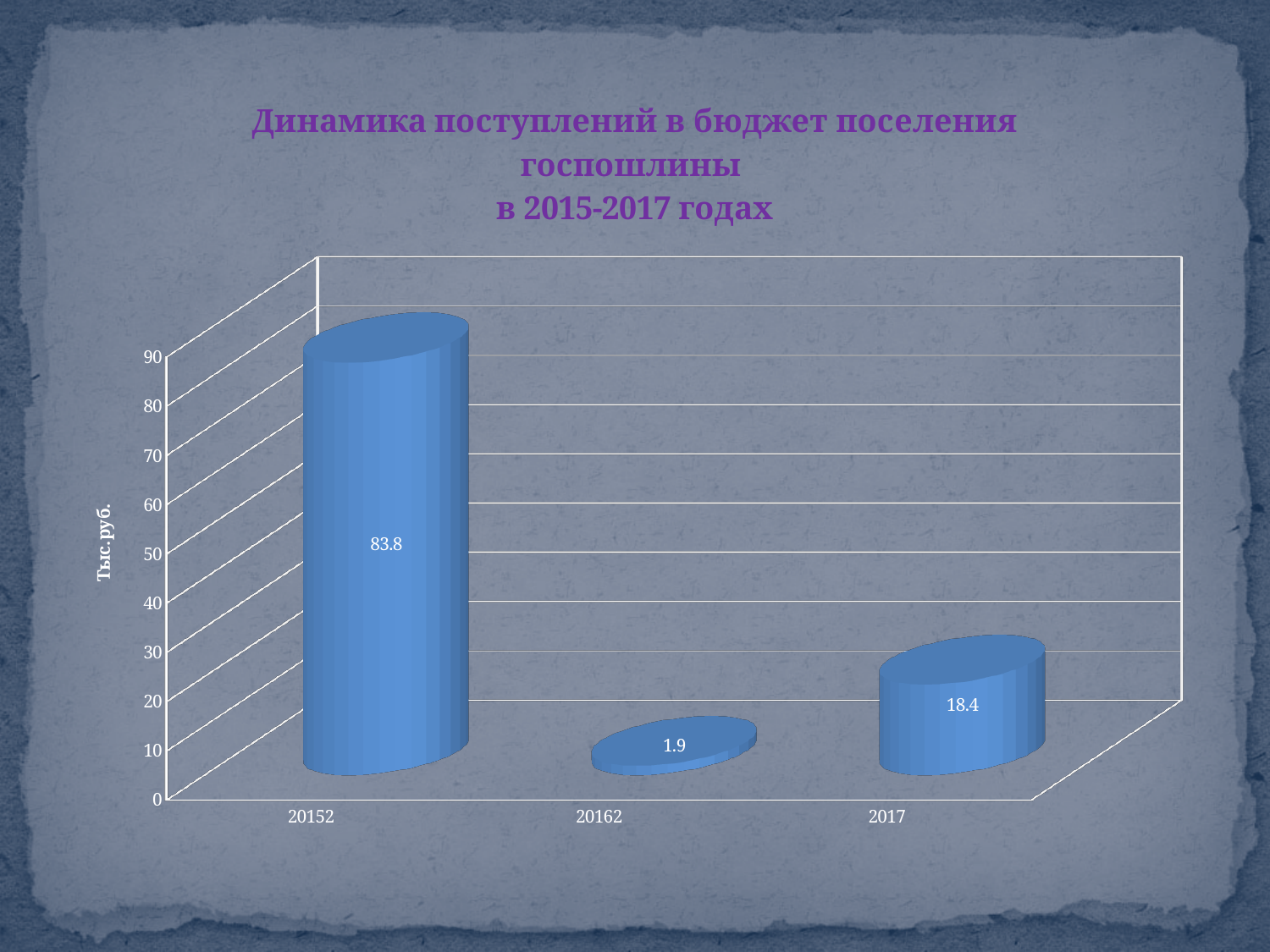
Which category has the lowest value? 20162 What is the value for 2017? 18.4 What is the label of the vertical axis? Тыс.руб. How many categories are shown on the x axis? 3 Which is larger, the value for 2017 or the value for 20162? 2017 What is the difference between the values for 20152 and 2017? 65.4 What is the value for the category labelled 20162? 1.9 Is the value for 20152 greater or less than 80? greater What is the value for the category labelled 20152? 83.8 Which category has the highest value? 20152 What kind of chart is shown on the slide? bar chart What is the difference between the values for 2017 and 20162? 16.5